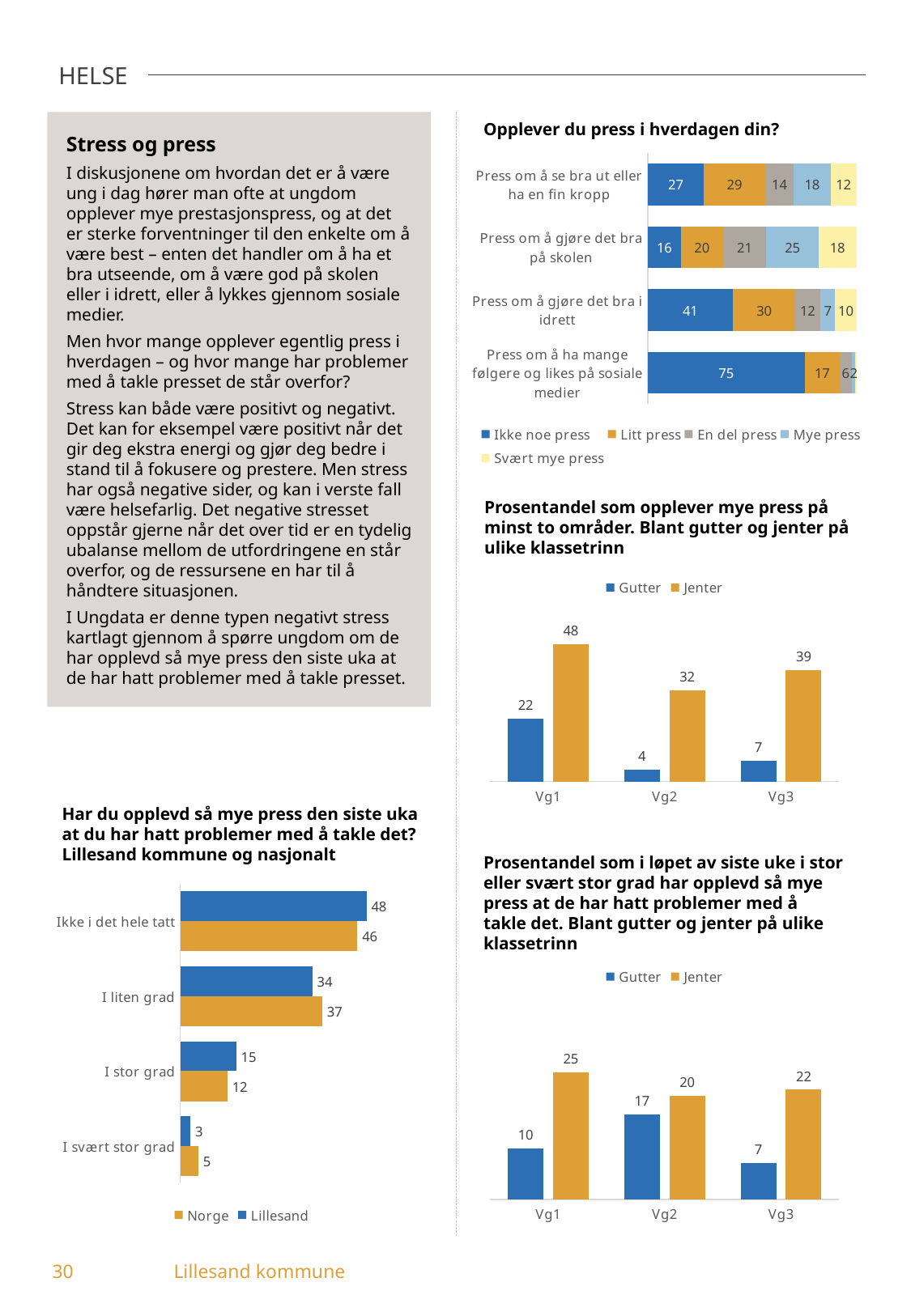
In the chart 'Har du opplevd så mye press den siste uka at du har hatt problemer med å takle det?', which is larger for 'I stor grad': Lillesand or Norge? Lillesand In the chart 'Prosentandel som i løpet av siste uke i stor eller svært stor grad har opplevd så mye press', what is the value for Gutter at Vg2? 17 In the chart 'Opplever du press i hverdagen din?', what is the 'Mye press' value for 'Press om å gjøre det bra på skolen'? 25 In the chart 'Har du opplevd så mye press den siste uka at du har hatt problemer med å takle det?', what is the Norge value for 'I liten grad'? 37 In the chart 'Opplever du press i hverdagen din?', what is the total of the stacked bar for 'Press om å gjøre det bra i idrett'? 100 In the chart 'Prosentandel som opplever mye press på minst to områder', what is the value for Jenter at Vg1? 48 What kind of chart is 'Har du opplevd så mye press den siste uka at du har hatt problemer med å takle det?'? Bar chart In the chart 'Opplever du press i hverdagen din?', how many series does the legend list? 5 In the chart 'Opplever du press i hverdagen din?', what is the 'Ikke noe press' value for 'Press om å ha mange følgere og likes på sosiale medier'? 75 In the chart 'Prosentandel som opplever mye press på minst to områder', which klassetrinn has the lowest value for Gutter? Vg2 In the chart 'Prosentandel som opplever mye press på minst to områder', what is the difference between Jenter and Gutter at Vg3? 32 In the chart 'Prosentandel som i løpet av siste uke i stor eller svært stor grad har opplevd så mye press', which klassetrinn has the highest value for Jenter? Vg1